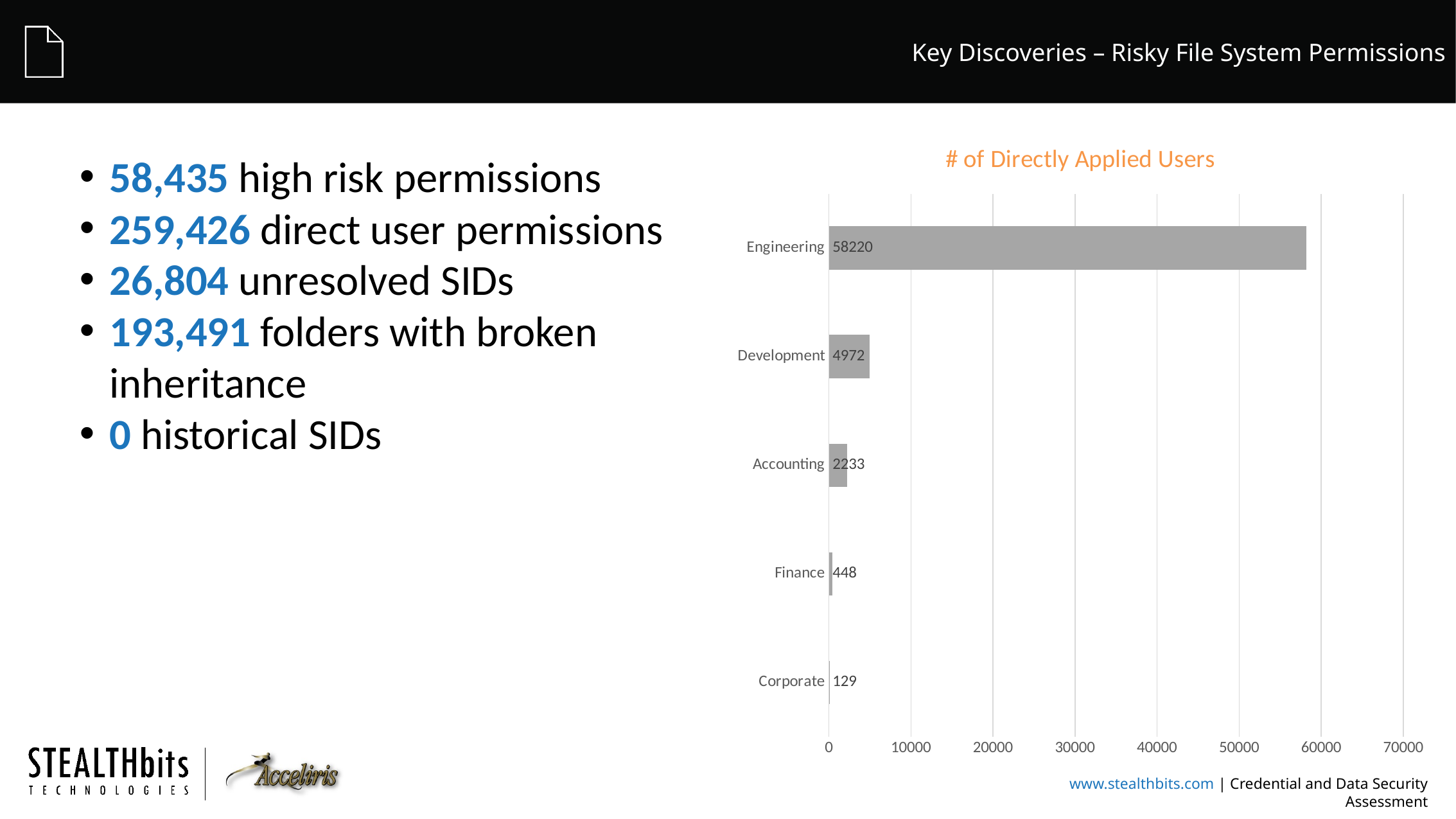
What is the value for Engineering in the chart? 58220 What is the value for Accounting in the chart? 2233 Which is larger, the value for Accounting or the value for Finance? Accounting What is the value for Corporate in the chart? 129 How many categories are shown in the chart? 5 What is the title of the chart? # of Directly Applied Users Which category has the lowest number of directly applied users? Corporate What is the value for Finance in the chart? 448 What is the difference between the values for Engineering and Development? 53248 Is the value for Engineering greater or less than 50000? greater Which category has the highest number of directly applied users? Engineering What is the value for Development in the chart? 4972